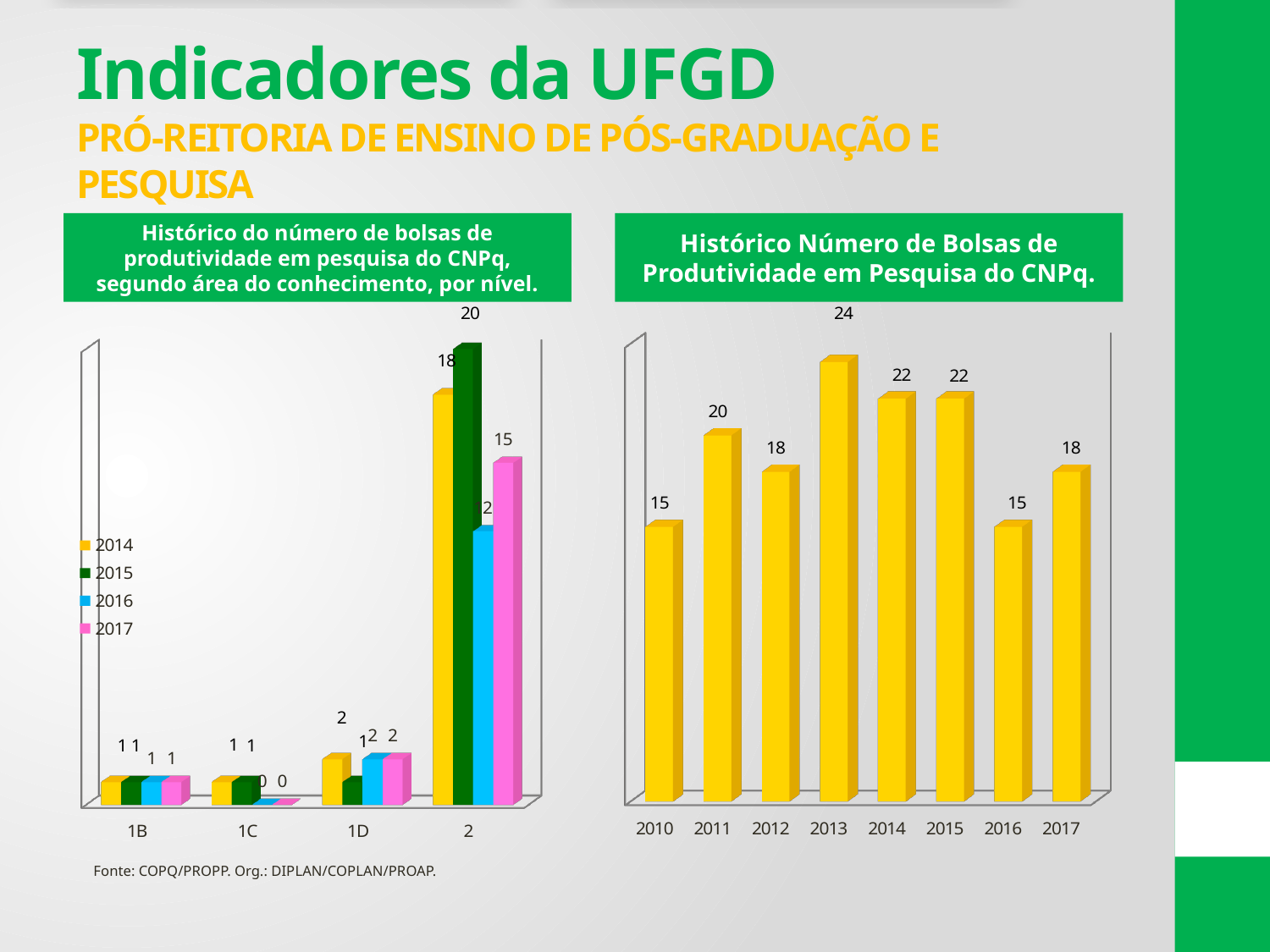
In the left chart (bolsas de produtividade segundo área do conhecimento, por nível), what is the 2014 value for category 2? 18 In the left chart (bolsas de produtividade segundo área do conhecimento, por nível), how many series does the legend list? 4 In the right chart (Histórico Número de Bolsas de Produtividade em Pesquisa do CNPq), how many years are shown on the x axis? 8 In the right chart (Histórico Número de Bolsas de Produtividade em Pesquisa do CNPq), what is the value for 2017? 18 In the right chart (Histórico Número de Bolsas de Produtividade em Pesquisa do CNPq), which year has the highest value? 2013 In the left chart (bolsas de produtividade segundo área do conhecimento, por nível), what is the 2015 value for category 2? 20 In the left chart (bolsas de produtividade segundo área do conhecimento, por nível), what is the 2017 value for category 1C? 0 What kind of chart is the left chart (bolsas de produtividade segundo área do conhecimento, por nível)? bar chart In the right chart (Histórico Número de Bolsas de Produtividade em Pesquisa do CNPq), what is the difference between the values for 2013 and 2010? 9 In the right chart (Histórico Número de Bolsas de Produtividade em Pesquisa do CNPq), do the values rise or fall from 2013 to 2016? fall In the right chart (Histórico Número de Bolsas de Produtividade em Pesquisa do CNPq), what is the value for 2013? 24 In the right chart (Histórico Número de Bolsas de Produtividade em Pesquisa do CNPq), which is larger, the value for 2011 or the value for 2012? 2011